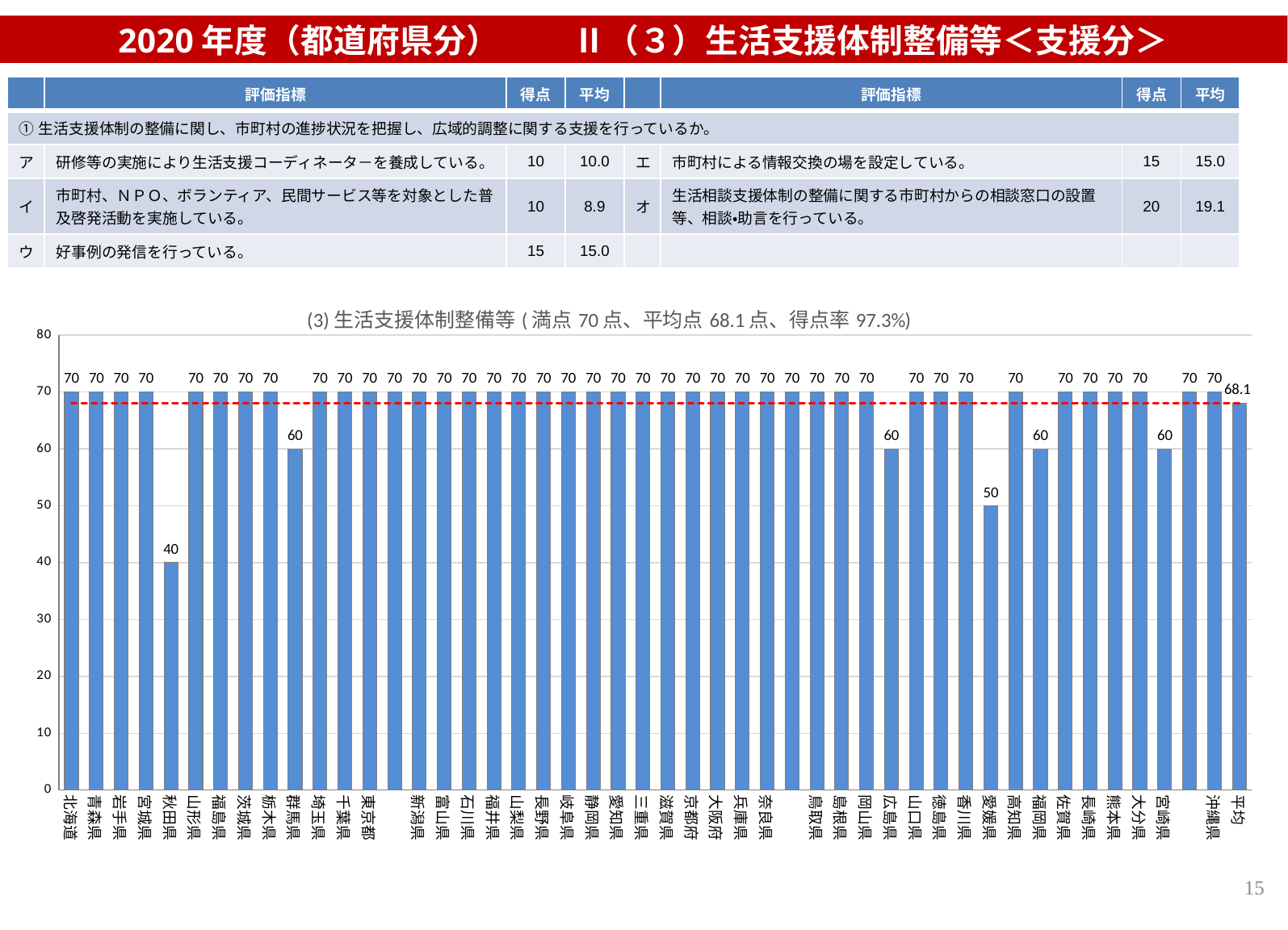
What is the value shown for 平均 (the last bar) in the chart? 68.1 What is the value for 北海道 in the bar chart? 70 What kind of chart is shown on the slide? bar chart Which prefecture has the lowest value in the bar chart? 秋田県 Is the value for 愛媛県 greater or less than 60? less Which is larger, the value for 広島県 or the value for 山口県? 山口県 What is the value for 秋田県 in the bar chart? 40 What is the value for 群馬県 in the bar chart? 60 What is the title of the chart? (3) 生活支援体制整備等 ( 満点 70 点、平均点 68.1 点、得点率 97.3%) What is the value for 愛媛県 in the bar chart? 50 What is the difference between the values for 高知県 and 福岡県? 10 What is the difference between the values for 北海道 and 秋田県? 30